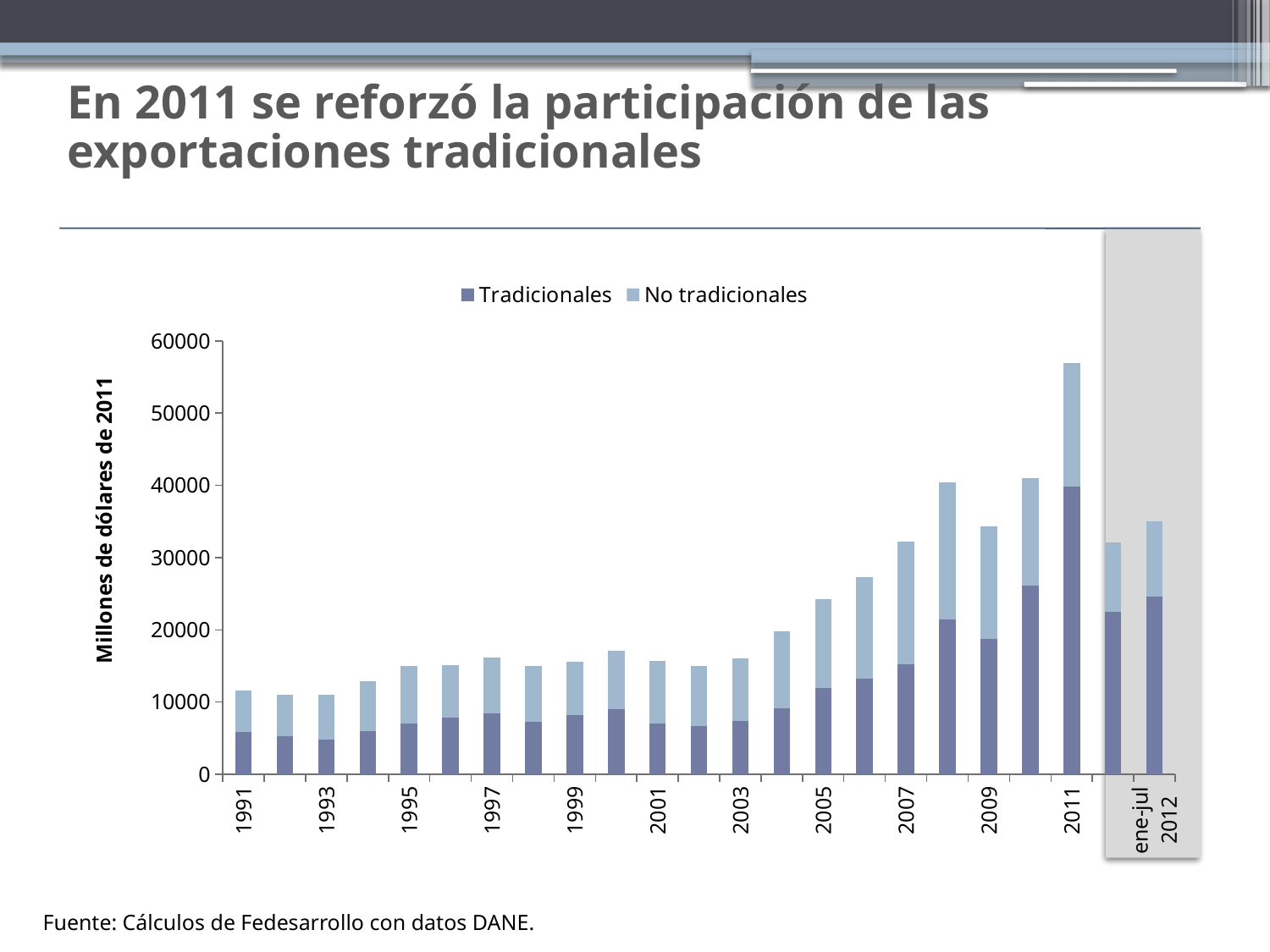
Do the total bars generally rise or fall from 2003 to 2011? Rise What are the two series named in the legend? Tradicionales and No tradicionales Is the Tradicionales value for 1991 greater or less than 10000? less Is the Tradicionales value for 2010 greater or less than 20000? greater Is the total value for 2011 greater or less than 50000? greater What is the label on the vertical axis? Millones de dólares de 2011 What kind of chart is shown on the slide? Stacked bar chart How many series does the legend list? 2 Which year has the larger total bar, 2003 or 2005? 2005 Which year has the highest total bar? 2011